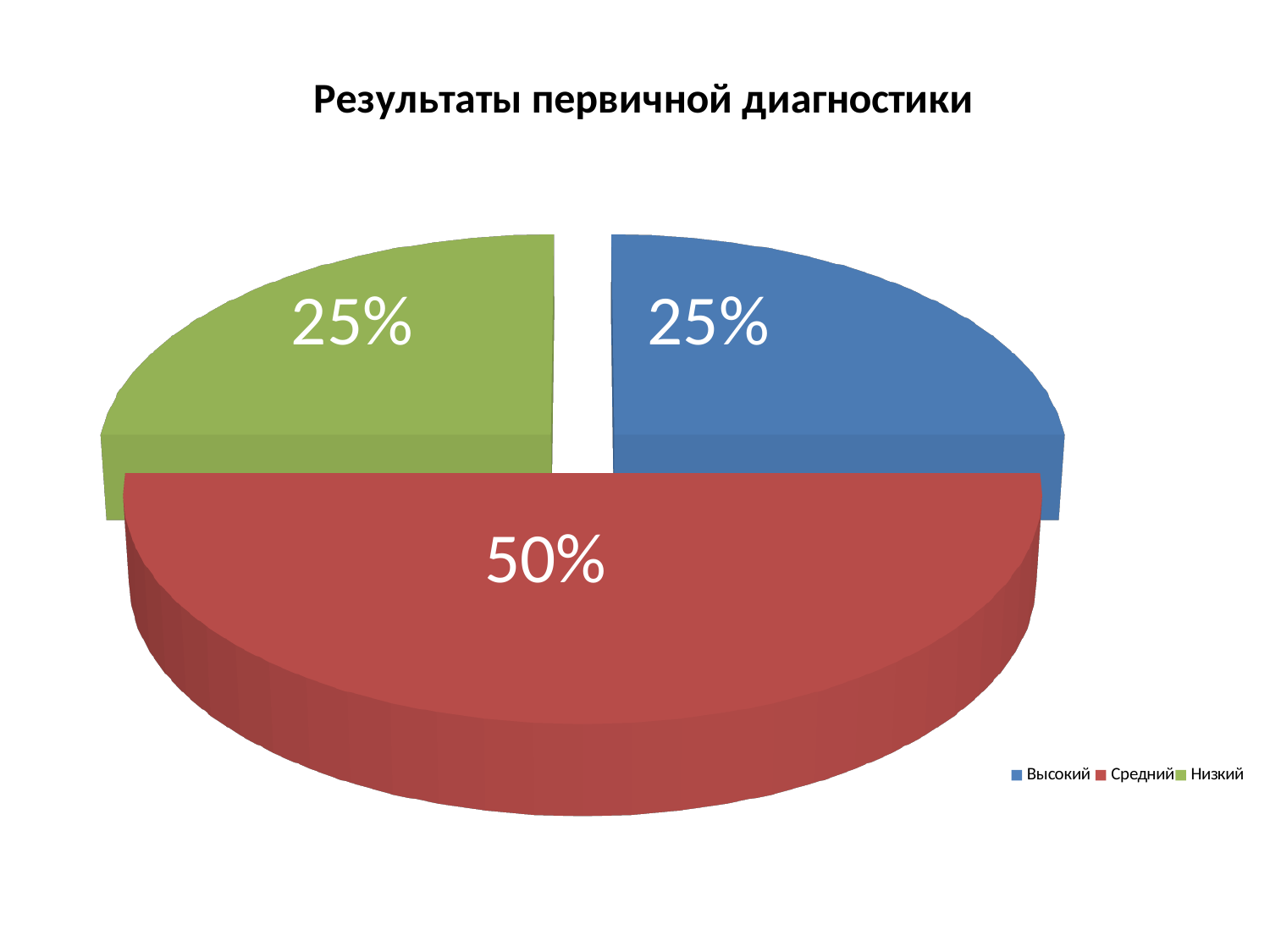
What is the title of the chart? Результаты первичной диагностики Which colour represents Средний in the chart? red What share of the pie does Высокий take? 25% How many slices does the pie chart have? 3 What is the difference between the shares of Средний and Высокий? 25% Which is larger, the share of Средний or the share of Низкий? Средний How many entries does the legend list? 3 What share of the pie does Низкий take? 25% What share of the pie does Средний take? 50% Which category has the largest slice of the pie? Средний What kind of chart is shown on the slide? pie chart